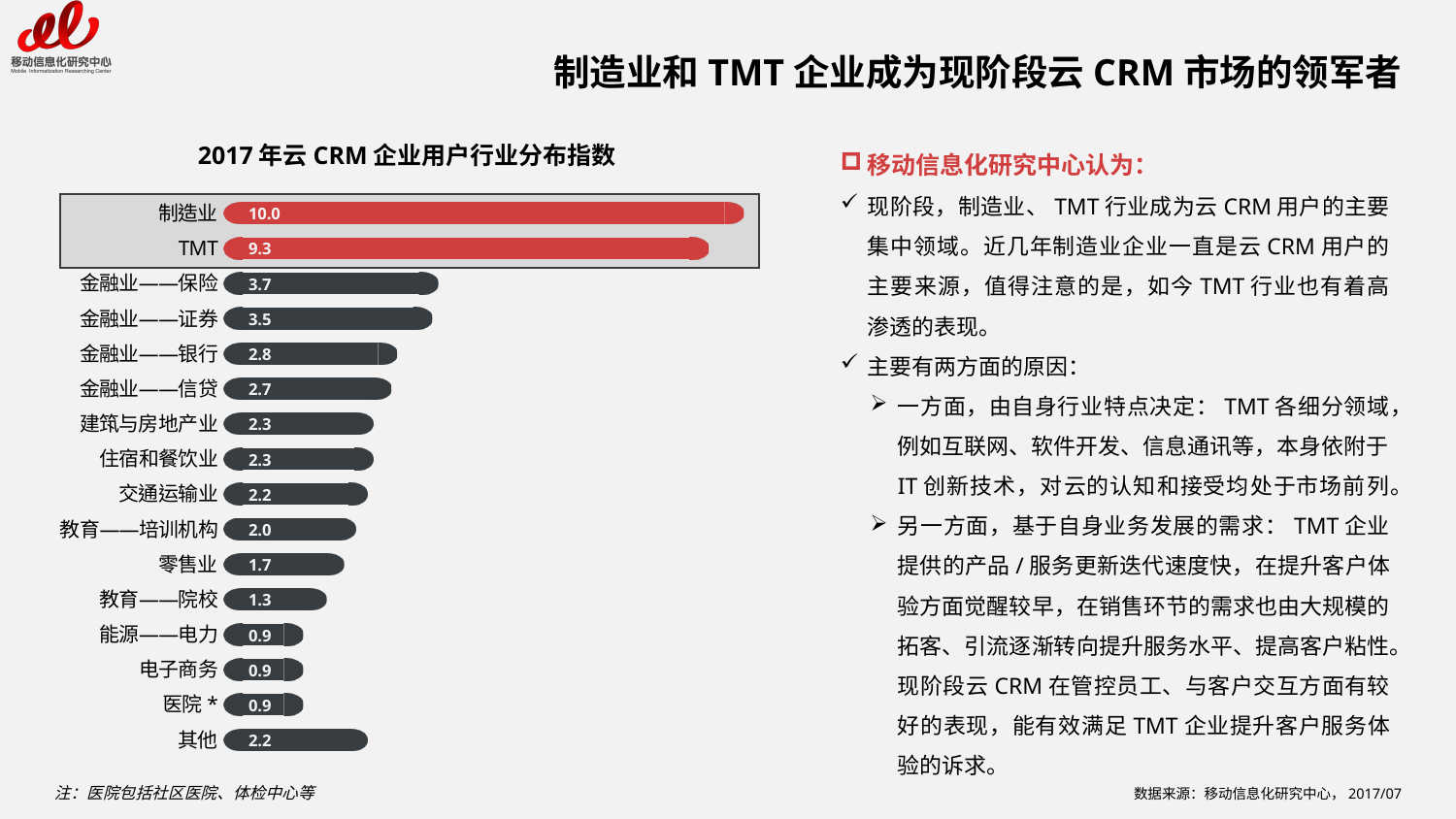
What is the value for 零售业? 1.7 Which has a larger value, 金融业——银行 or 教育——院校? 金融业——银行 What is the value for 金融业——保险? 3.7 How many categories are shown in the chart? 16 What is the difference between the values for 金融业——保险 and 金融业——证券? 0.2 What is the title of the chart? 2017年云CRM企业用户行业分布指数 Which two categories are highlighted with red bars? 制造业 and TMT What is the value for 制造业? 10.0 What type of chart is shown on the slide? bar chart Which category has the highest value? 制造业 What is the value for TMT? 9.3 What is the difference between the values for 制造业 and TMT? 0.7